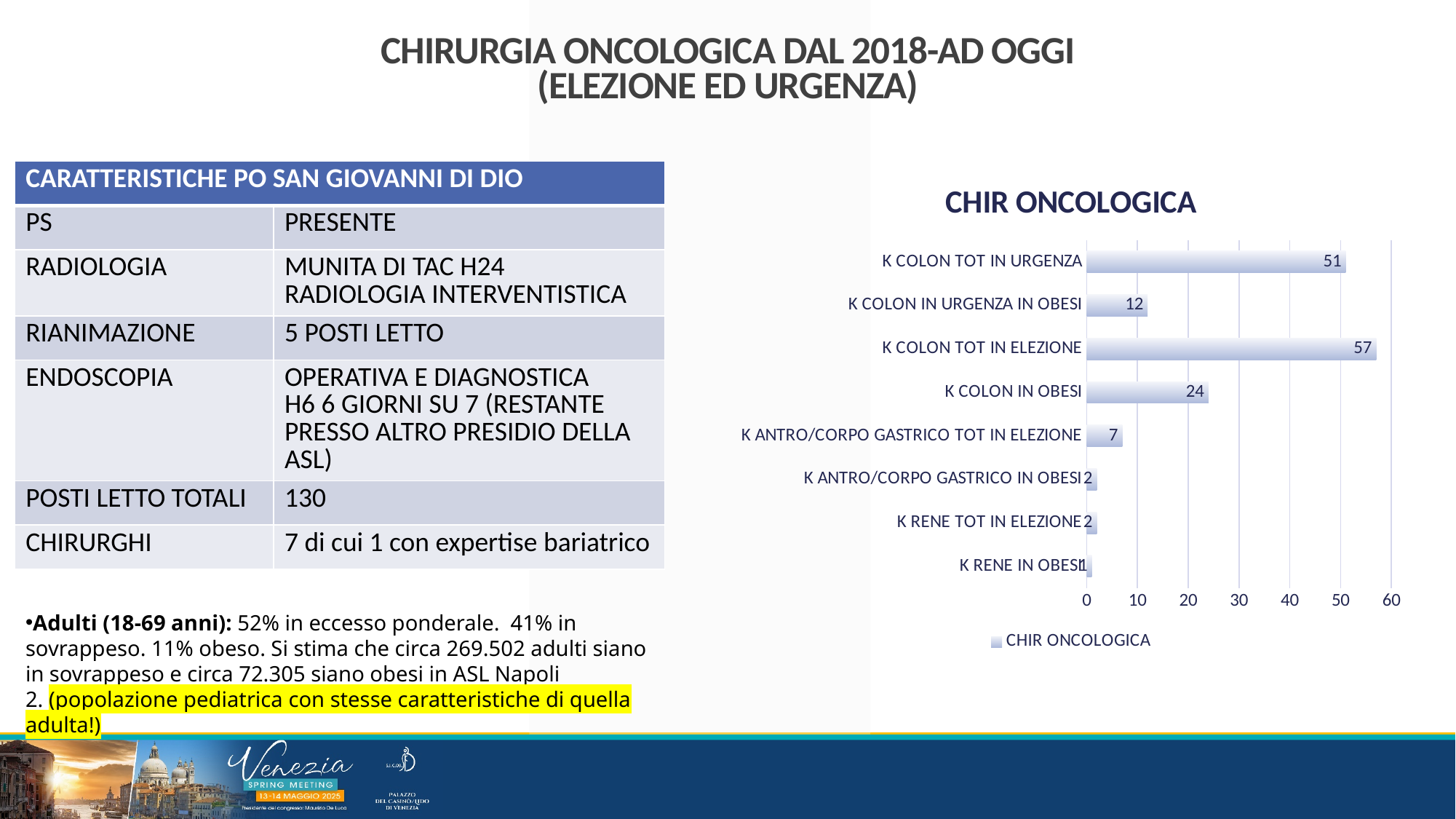
What is the value for K COLON TOT IN URGENZA? 51 What kind of chart is shown on the slide? Bar chart What is the value for K COLON IN URGENZA IN OBESI? 12 How many categories are shown in the chart? 8 What is the value for K ANTRO/CORPO GASTRICO TOT IN ELEZIONE? 7 What is the difference between K COLON TOT IN ELEZIONE and K COLON TOT IN URGENZA? 6 Which is larger, K COLON IN OBESI or K ANTRO/CORPO GASTRICO TOT IN ELEZIONE? K COLON IN OBESI Which category has the lowest value in the chart? K RENE IN OBESI What is the value for K COLON TOT IN ELEZIONE? 57 What is the title of the chart? CHIR ONCOLOGICA Which category has the highest value in the chart? K COLON TOT IN ELEZIONE What is the difference between K COLON IN OBESI and K COLON IN URGENZA IN OBESI? 12